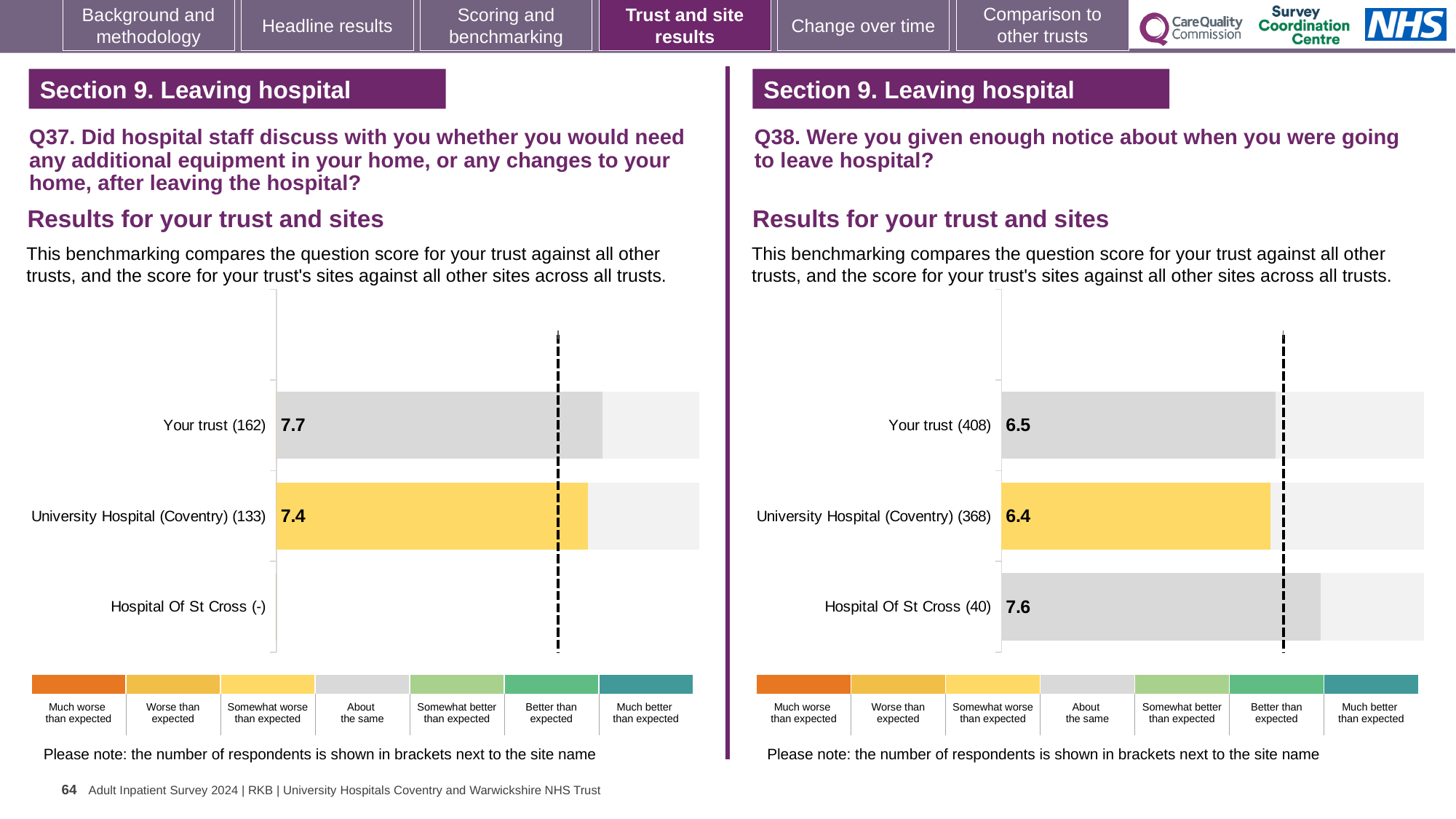
In the Q38 chart on the right, which site or trust has the highest score? Hospital Of St Cross In the Q38 chart on the right, which site or trust has the lowest score? University Hospital (Coventry) In the Q38 chart on the right, how many respondents are shown in brackets for University Hospital (Coventry)? 368 In the Q37 chart on the left, what is the score for Your trust? 7.7 In the Q37 chart on the left, which has the higher score, Your trust or University Hospital (Coventry)? Your trust In the Q38 chart on the right, what is the difference between the score for Hospital Of St Cross and the score for Your trust? 1.1 In the Q38 chart on the right, which colour category does the University Hospital (Coventry) bar fall into according to the legend? Somewhat worse than expected In the Q37 chart on the left, what is the difference between the score for Your trust and the score for University Hospital (Coventry)? 0.3 In the Q38 chart on the right, what is the score for Your trust? 6.5 What kind of chart is used in the Q37 chart on the left? Bar chart In the Q37 chart on the left, what is the score for University Hospital (Coventry)? 7.4 In the Q38 chart on the right, what is the score for Hospital Of St Cross? 7.6